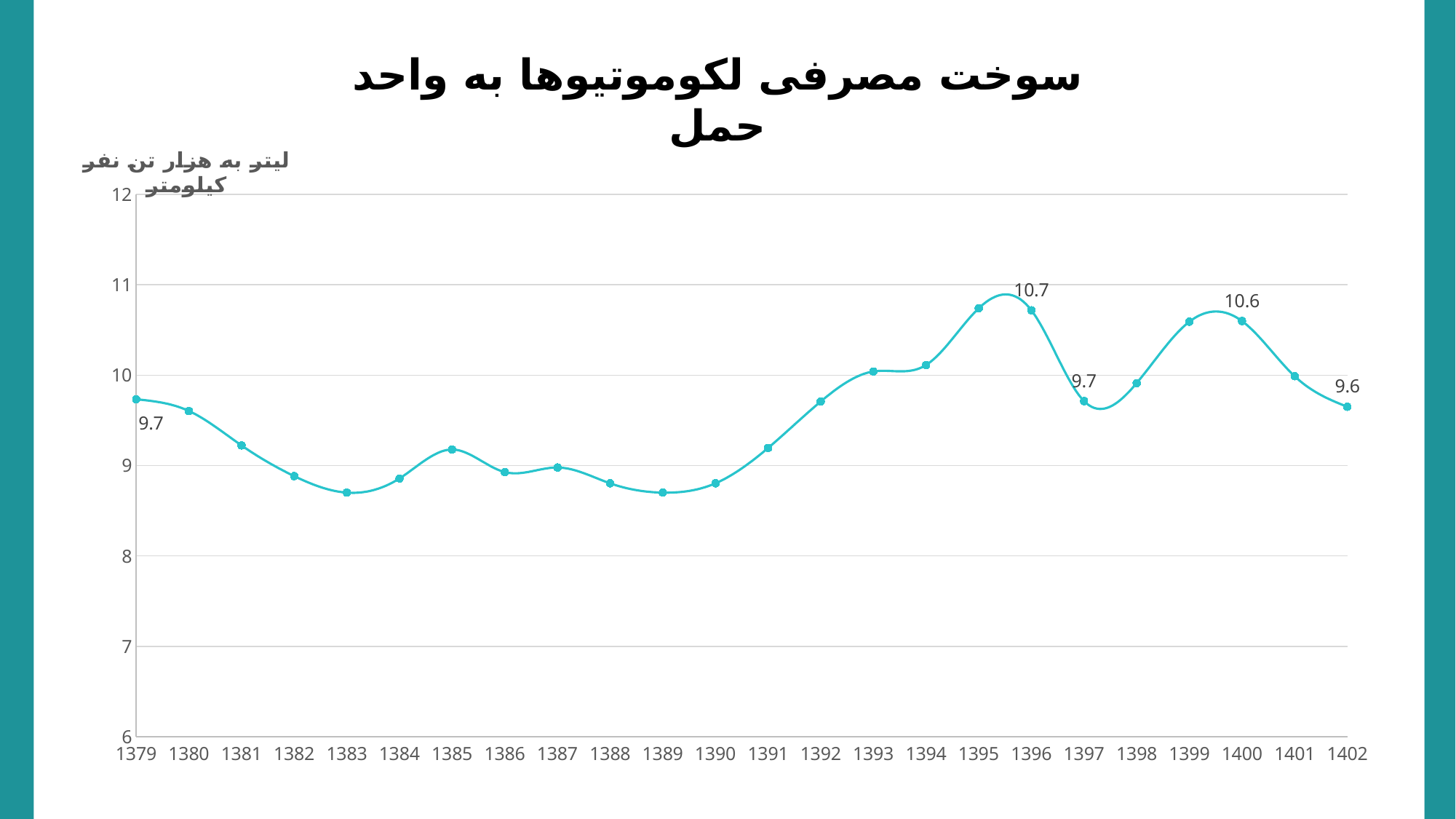
What is the difference between the values for 1396 and 1397? 1.0 What is the value for 1400? 10.6 Which is larger, the value for 1396 or the value for 1402? 1396 Is the value for 1383 greater or less than 9? less What kind of chart is shown on the slide? line chart What is the difference between the values for 1400 and 1402? 1.0 What is the value for 1402? 9.6 What is the value for 1396? 10.7 Do the values rise or fall from 1390 to 1395? rise What is the value for 1397? 9.7 How many years are plotted on the x axis? 24